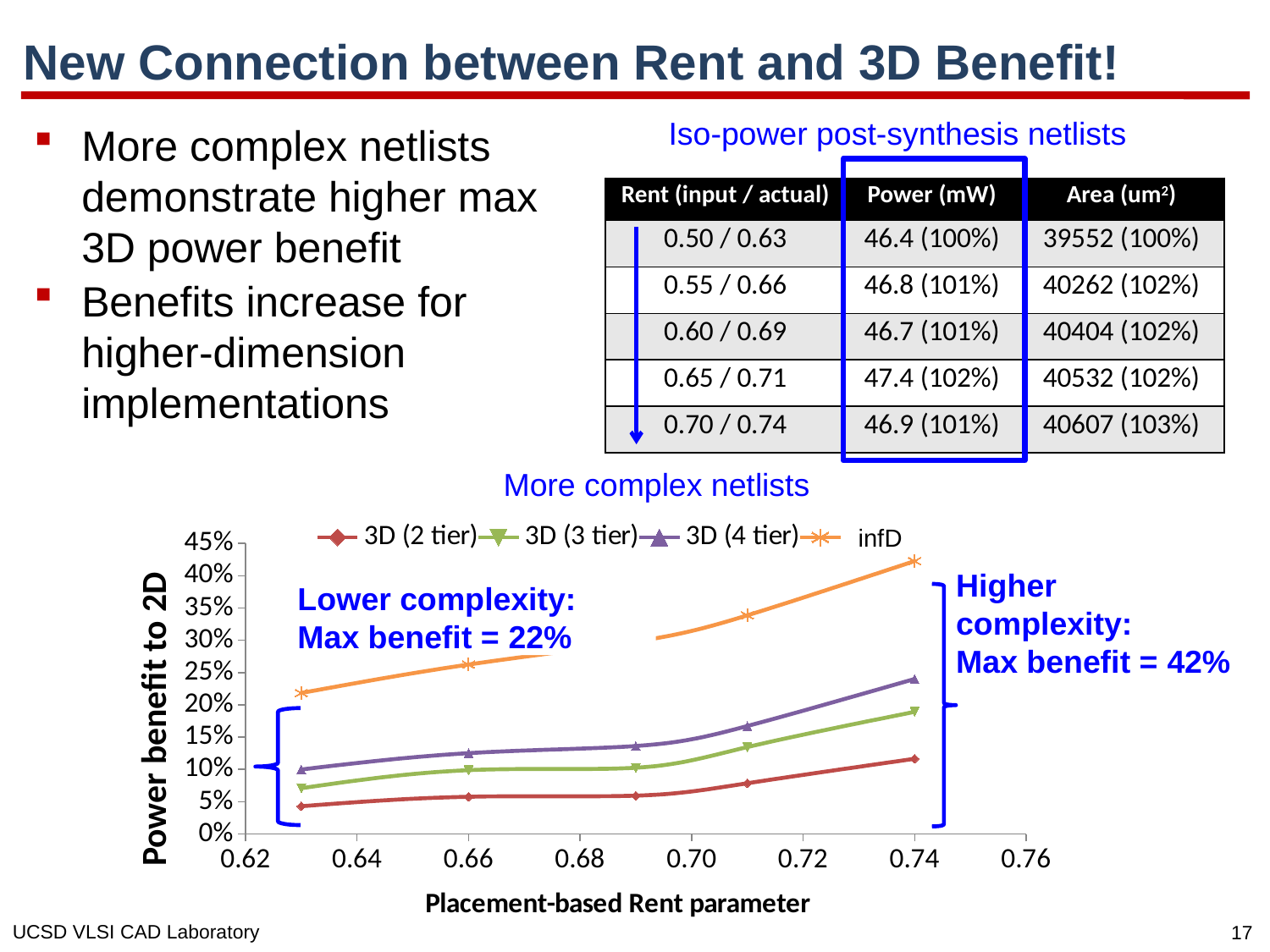
How many data points are plotted for the infD series? 5 Which series has the lowest power benefit to 2D across the chart? 3D (2 tier) Which series has the highest power benefit to 2D across the chart? infD Does the power benefit for the infD series rise or fall as the placement-based Rent parameter increases? rise At Rent parameter 0.74, which series has the larger power benefit, infD or 3D (2 tier)? infD Is the value for 3D (3 tier) at Rent parameter 0.63 greater or less than 10%? less How many series does the legend of the chart list? 4 Is the value for infD at Rent parameter 0.74 greater or less than 40%? greater What is the title of the x axis of the chart? Placement-based Rent parameter What kind of chart is shown at the bottom of the slide? line chart Is the value for 3D (4 tier) at Rent parameter 0.74 greater or less than 20%? greater